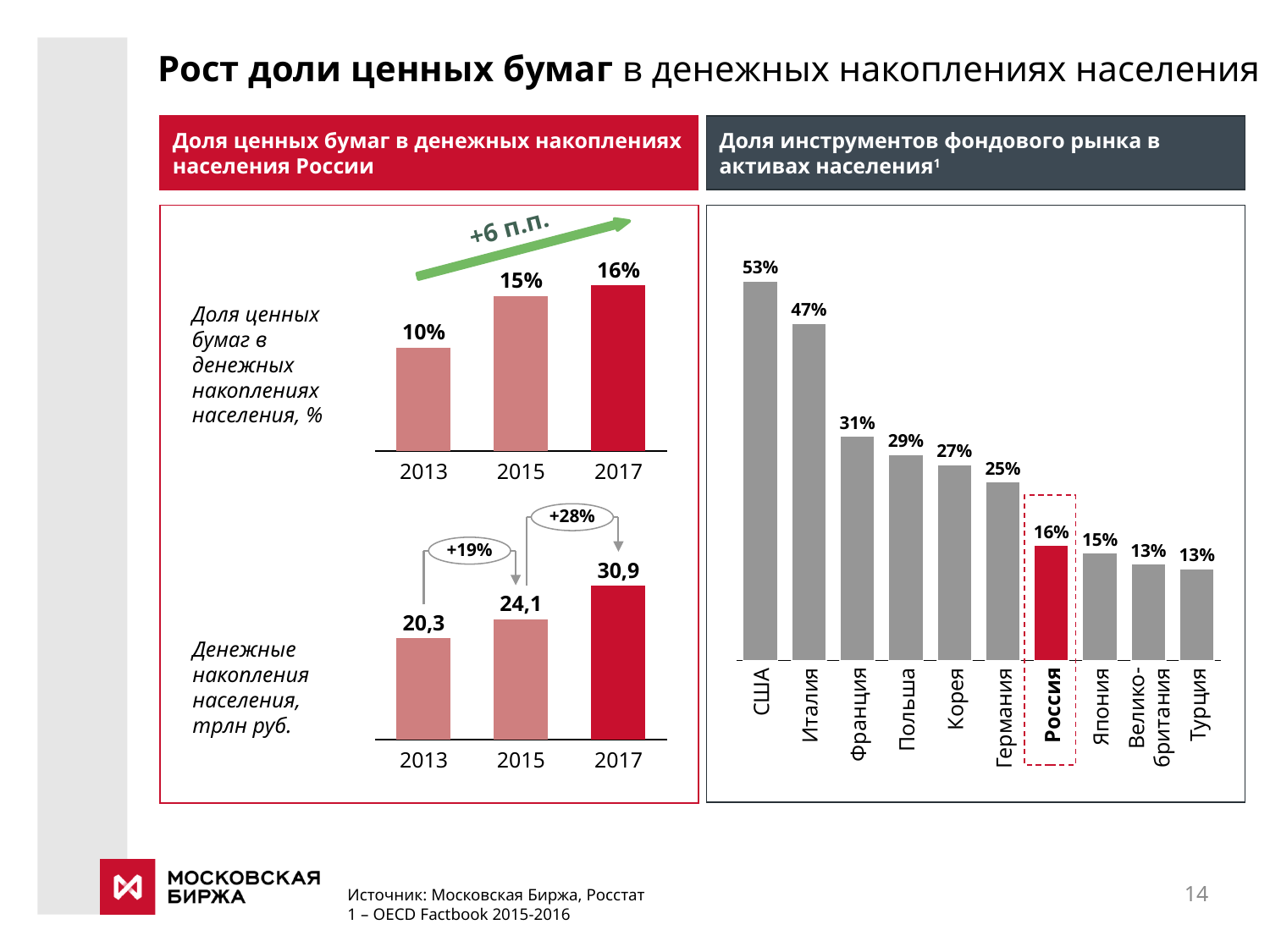
In the right chart (Доля инструментов фондового рынка в активах населения), how many countries are shown? 10 In the right chart (Доля инструментов фондового рынка в активах населения), what is the value for Италия? 47% In the top-left chart (Доля ценных бумаг в денежных накоплениях населения, %), what is the value for 2013? 10% In the bottom-left chart (Денежные накопления населения, трлн руб.), what is the value for 2015? 24,1 In the top-left chart (Доля ценных бумаг в денежных накоплениях населения, %), what is the value for 2017? 16% In the right chart (Доля инструментов фондового рынка в активах населения), which country has the highest value? США In the bottom-left chart (Денежные накопления населения, трлн руб.), what is the value for 2017? 30,9 In the bottom-left chart (Денежные накопления населения, трлн руб.), do the values rise or fall from 2013 to 2017? rise What kind of chart is the right chart (Доля инструментов фондового рынка в активах населения)? bar chart In the right chart (Доля инструментов фондового рынка в активах населения), which is larger, the value for Польша or the value for Корея? Польша In the top-left chart (Доля ценных бумаг в денежных накоплениях населения, %), what is the difference between the 2017 and 2013 values? 6 percentage points In the right chart (Доля инструментов фондового рынка в активах населения), what is the value for Россия? 16%